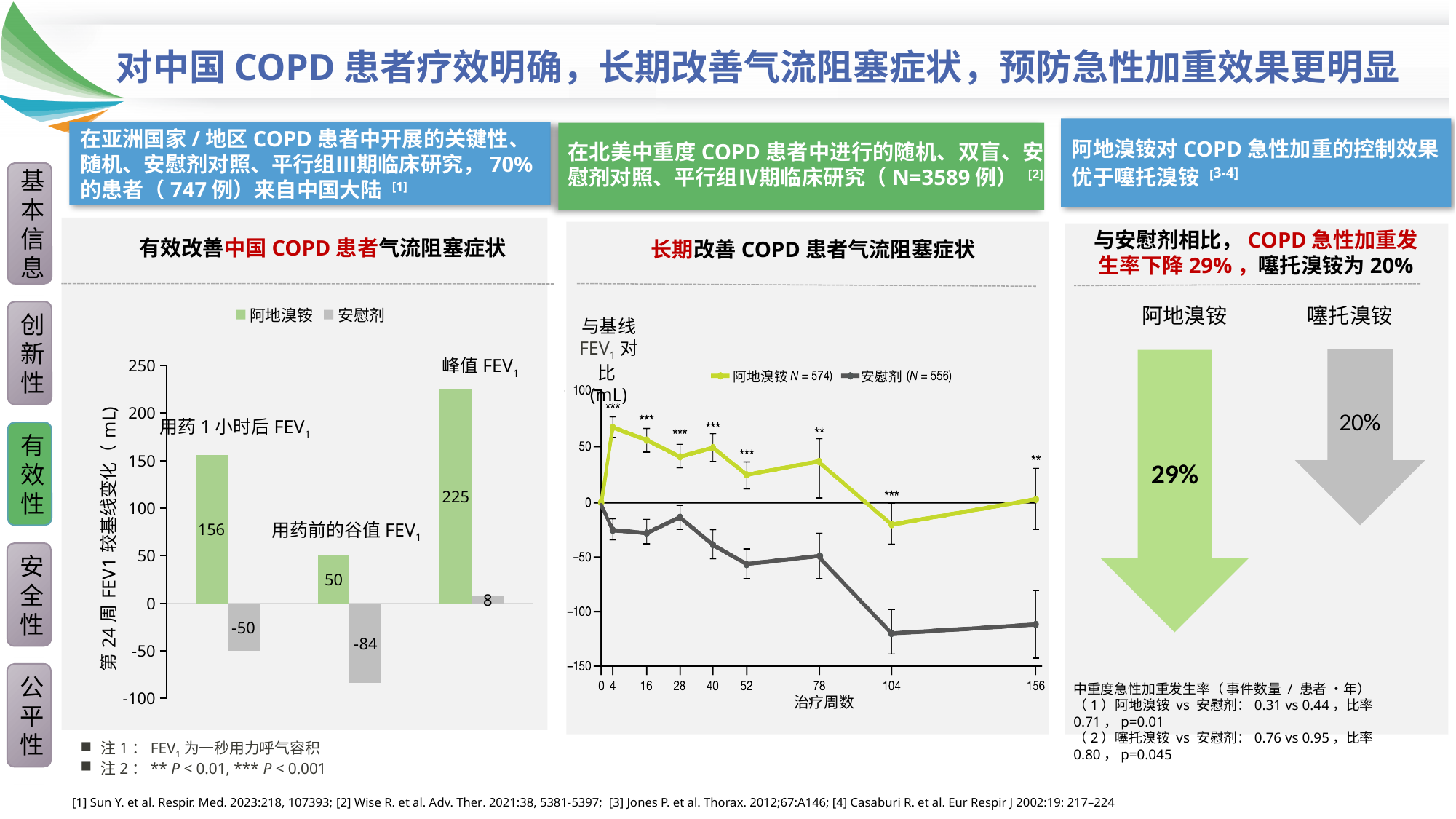
On the left bar chart, what is the value for 安慰剂 at 用药前的谷值 FEV1? -84 On the left chart titled 有效改善中国 COPD 患者气流阻塞症状, what is the value for 阿地溴铵 at 用药 1 小时后 FEV1? 156 What kind of chart is the left chart titled 有效改善中国 COPD 患者气流阻塞症状? bar chart On the left bar chart, how many series does the legend list? 2 On the left bar chart, which category has the highest 阿地溴铵 value? 峰值 FEV1 On the middle line chart, is the value for 安慰剂 at week 104 greater or less than -100? less On the left bar chart, which category has the lowest 安慰剂 value? 用药前的谷值 FEV1 What kind of chart is the middle chart titled 长期改善 COPD 患者气流阻塞症状? line chart On the middle line chart, is the value for 阿地溴铵 at week 4 greater or less than 50? greater On the left bar chart, what is the value for 安慰剂 at 峰值 FEV1? 8 On the left bar chart, what is the difference between the 阿地溴铵 and 安慰剂 values at 峰值 FEV1? 217 On the left bar chart, which is larger: the 阿地溴铵 value at 用药 1 小时后 FEV1 or at 用药前的谷值 FEV1? 用药 1 小时后 FEV1